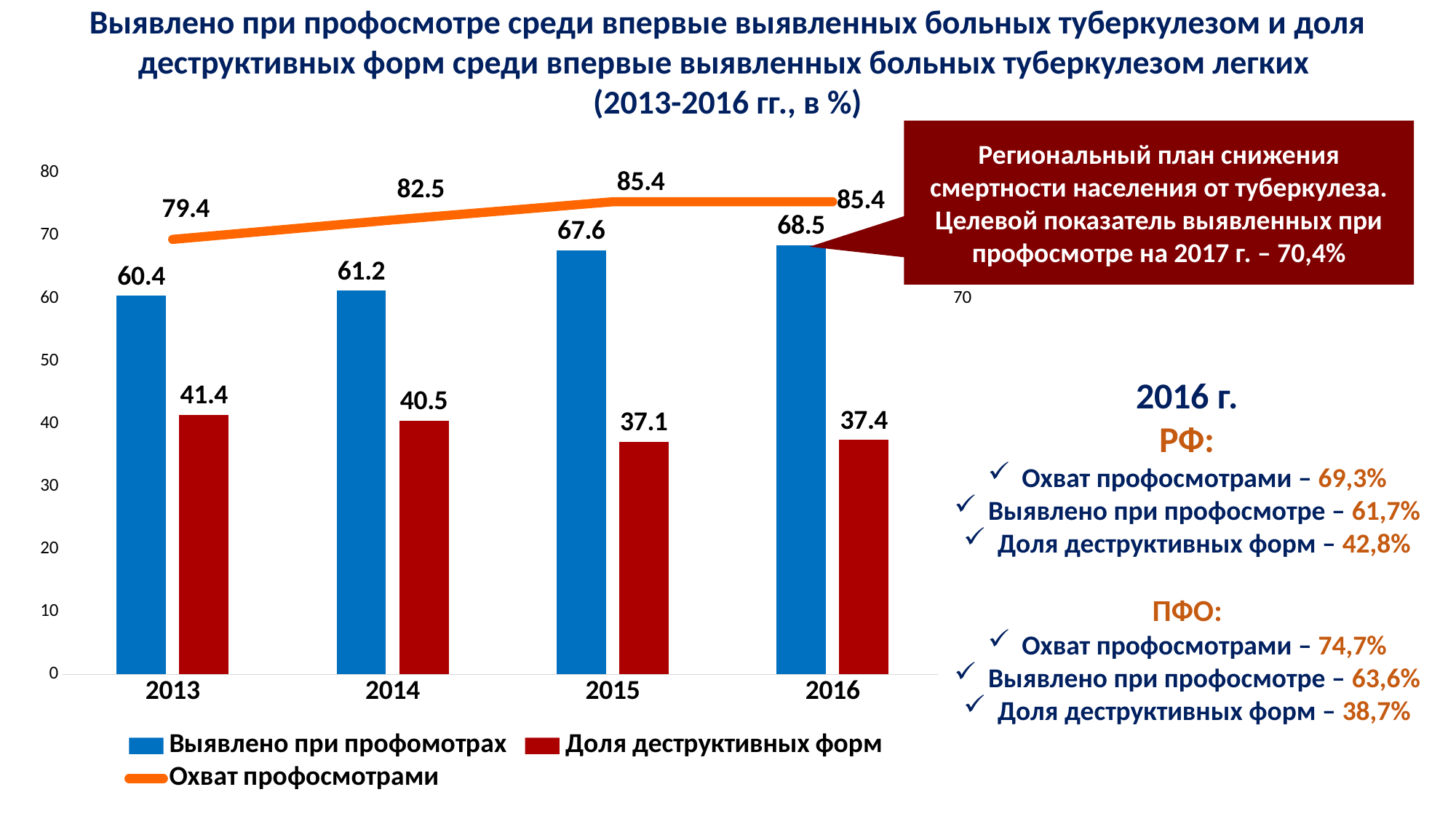
What is the value of «Охват профосмотрами» for 2014? 82.5 Does «Доля деструктивных форм» generally rise or fall from 2013 to 2016? fall In which year is «Доля деструктивных форм» lowest? 2015 How many series does the chart legend list? 3 Which is larger: «Выявлено при профомотрах» in 2013 or in 2014? 2014 What is the value of «Доля деструктивных форм» for 2013? 41.4 Which series is drawn as an orange line in the chart? Охват профосмотрами How many years are shown on the x axis of the chart? 4 Is the value of «Доля деструктивных форм» for 2014 greater or less than 40? greater In which year is «Выявлено при профомотрах» highest? 2016 What is the value of «Выявлено при профомотрах» for 2015? 67.6 What is the difference between «Выявлено при профомотрах» and «Доля деструктивных форм» in 2016? 31.1